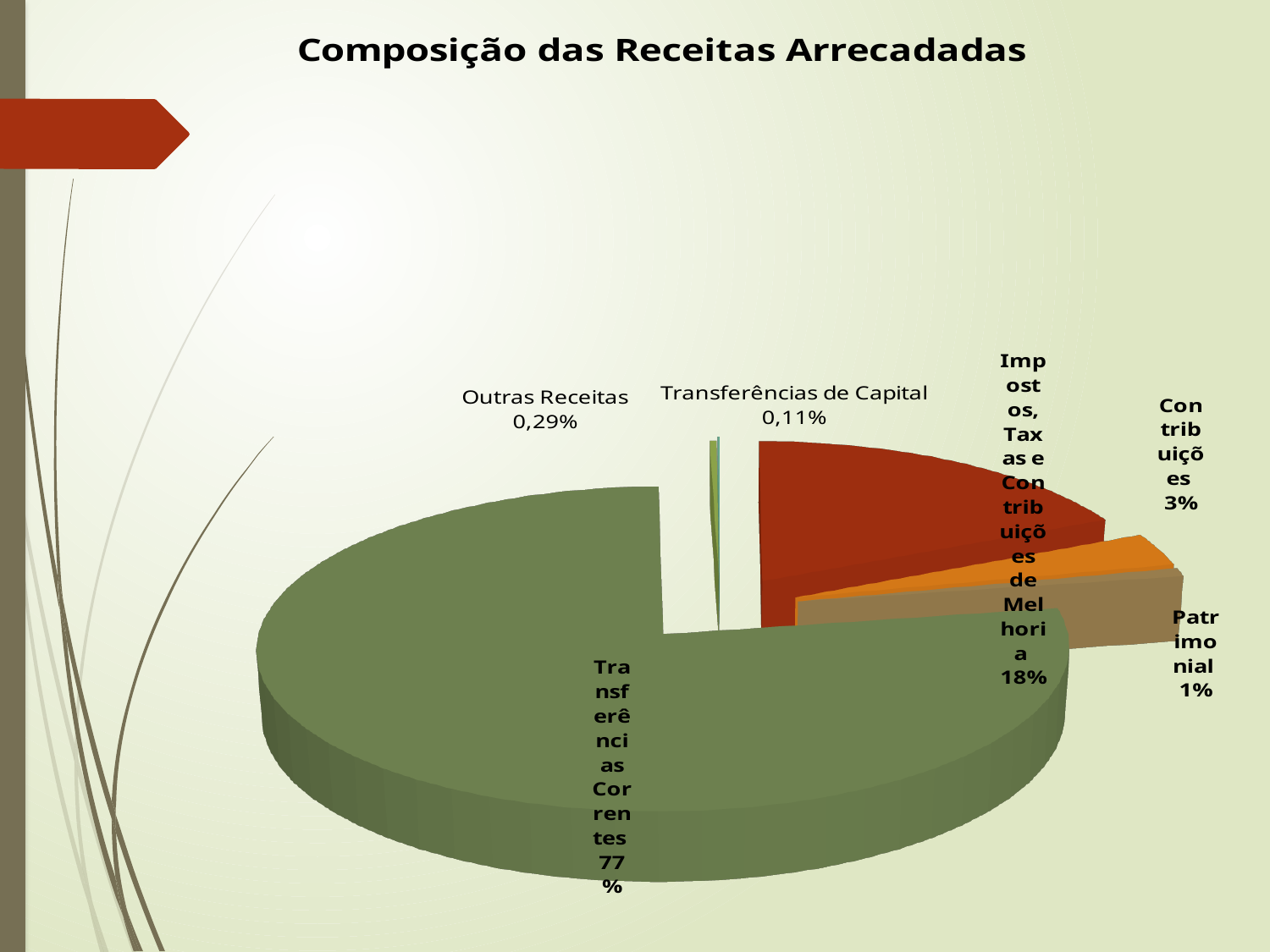
Which category has the smallest slice of the pie? Transferências de Capital What is the value shown for Contribuições? 3% What is the value shown for Patrimonial? 1% Which category has the largest slice of the pie? Transferências Correntes What is the difference in percentage points between Transferências Correntes and Impostos, Taxas e Contribuições de Melhoria? 59 What is the title of the chart? Composição das Receitas Arrecadadas What share of the pie does Impostos, Taxas e Contribuições de Melhoria represent? 18% What is the value shown for Outras Receitas? 0,29% What share of the pie does Transferências Correntes represent? 77% How many categories are shown in the pie chart? 6 What is the value shown for Transferências de Capital? 0,11% What kind of chart is shown on the slide? Pie chart